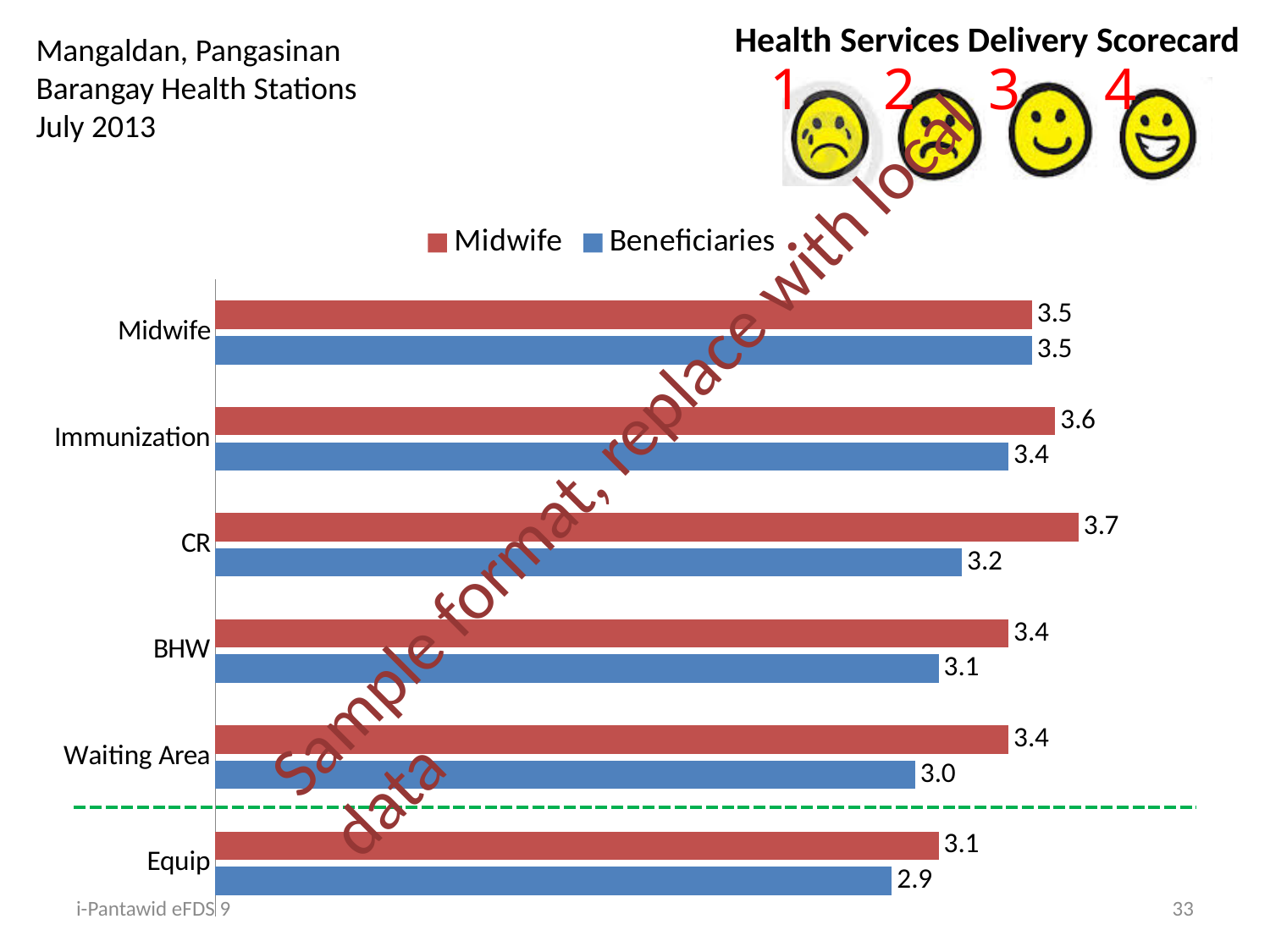
Which colour represents the Beneficiaries series? Blue Which category has the highest Midwife series value? CR Which is larger for BHW, the Midwife value or the Beneficiaries value? Midwife What is the difference between the Midwife and Beneficiaries values for CR? 0.5 Which category has the lowest Beneficiaries value? Equip How many series does the legend list? 2 What is the difference between the Midwife and Beneficiaries values for Equip? 0.2 How many categories are shown on the chart? 6 What is the Midwife series value for CR? 3.7 What is the Beneficiaries value for Waiting Area? 3.0 What kind of chart is shown on the slide? Bar chart What is the Beneficiaries value for Immunization? 3.4